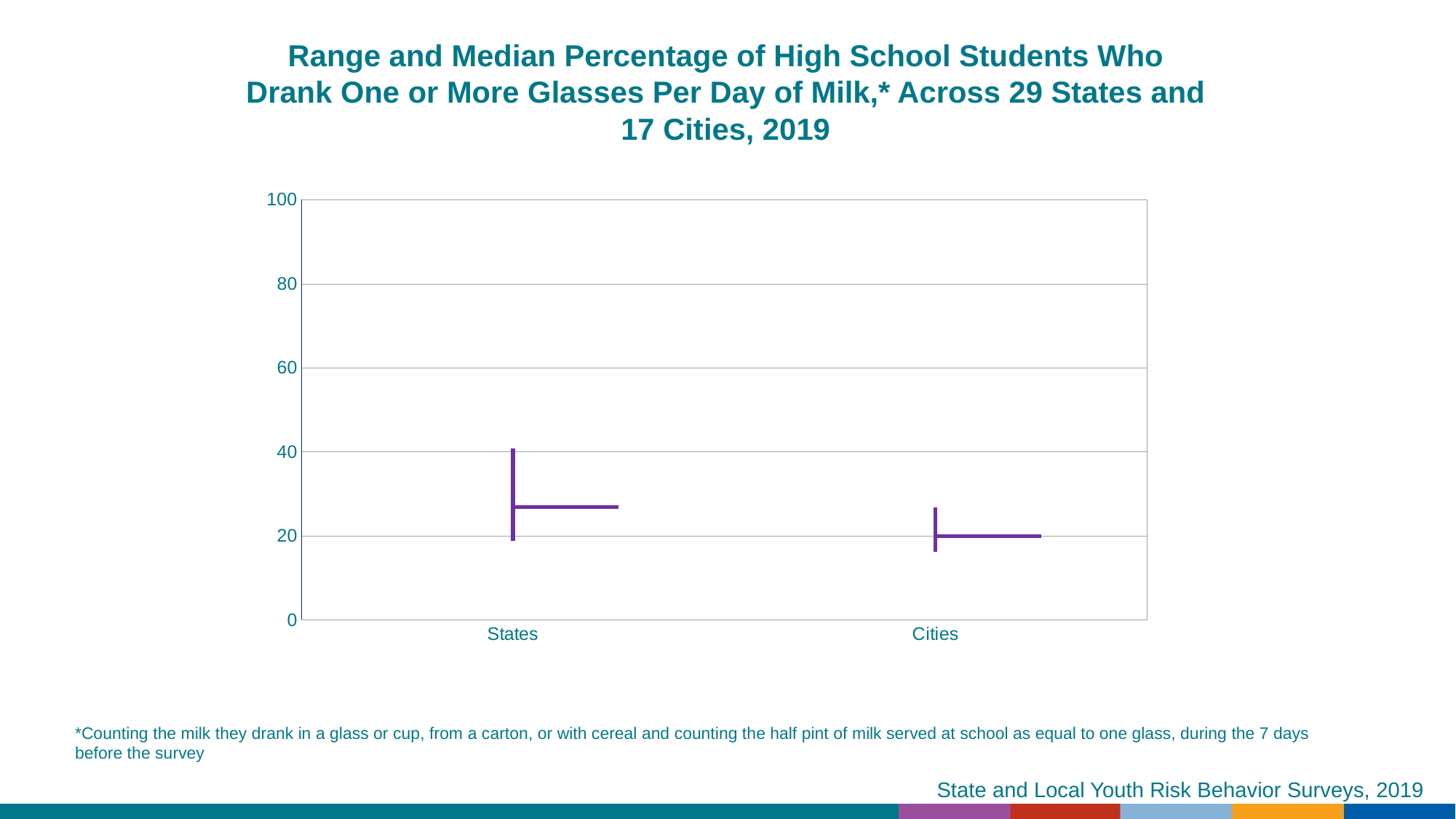
According to the chart title, how many states and how many cities are included? 29 states and 17 cities How many categories are shown on the x axis of the chart? 2 Which category has the higher median percentage, States or Cities? States Is the median value for States greater or less than 20? greater Is the median value for Cities greater or less than 40? less Which category shows the lowest bottom of its range? Cities What is the maximum value shown on the y axis? 100 Is the bottom of the range for Cities greater or less than 20? less Which category shows the highest top of its range? States